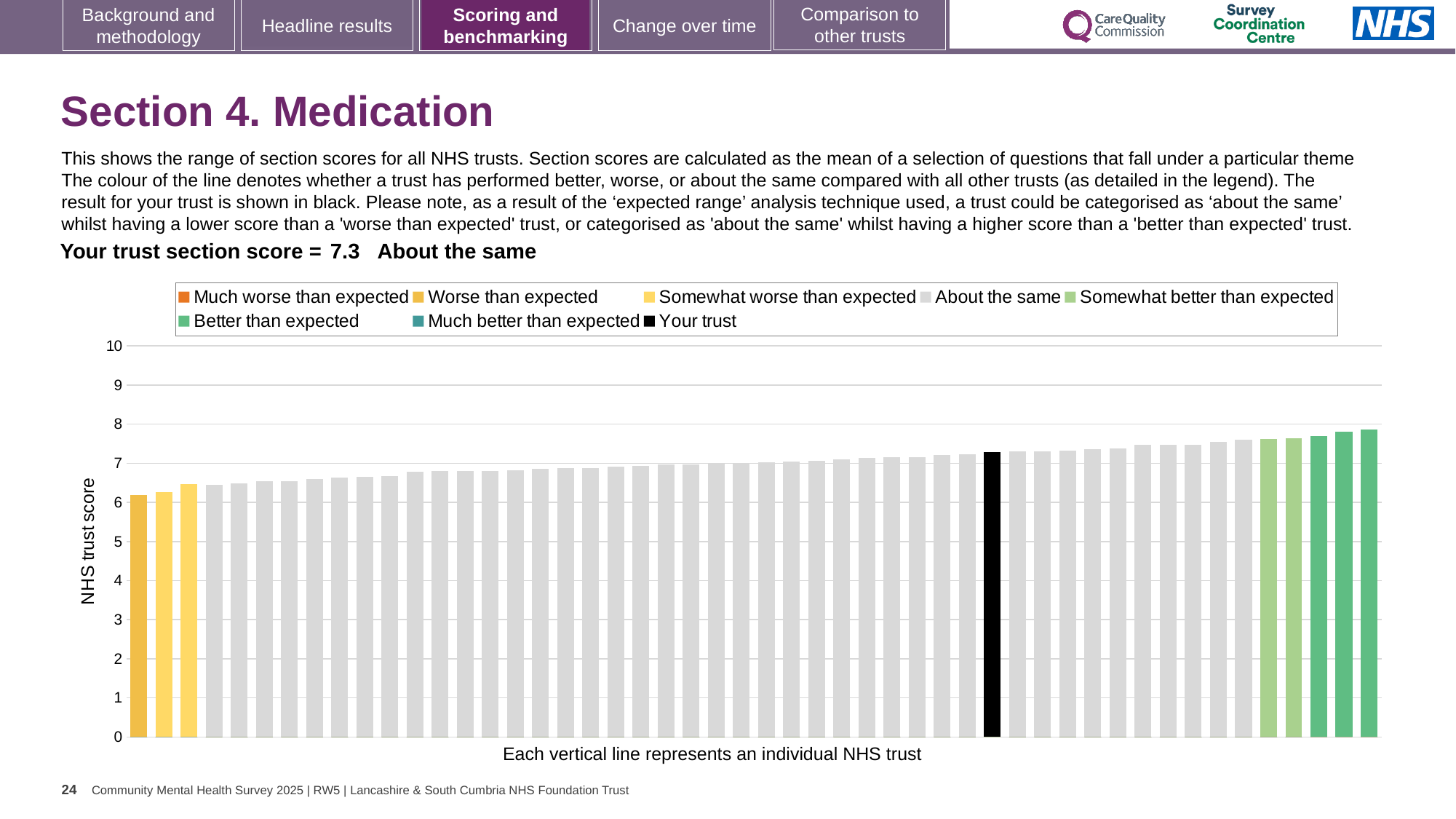
What colour is the bar representing your trust? Black Is the value of the highest bar in the chart greater or less than 8? less What is the section score for your trust shown on the slide? 7.3 Do the bar values rise or fall from left to right along the x axis? Rise How many entries does the chart legend list? 8 Which category is your trust placed in for this section? About the same What is the title of the vertical axis? NHS trust score What kind of chart is shown on the slide? Bar chart Is the value of the lowest bar in the chart greater or less than 7? less Is the value for your trust's bar greater or less than 7? greater Is your trust's bar higher or lower than the lowest bar in the chart? Higher How many bars are coloured yellow (worse than expected categories) in the chart? 3